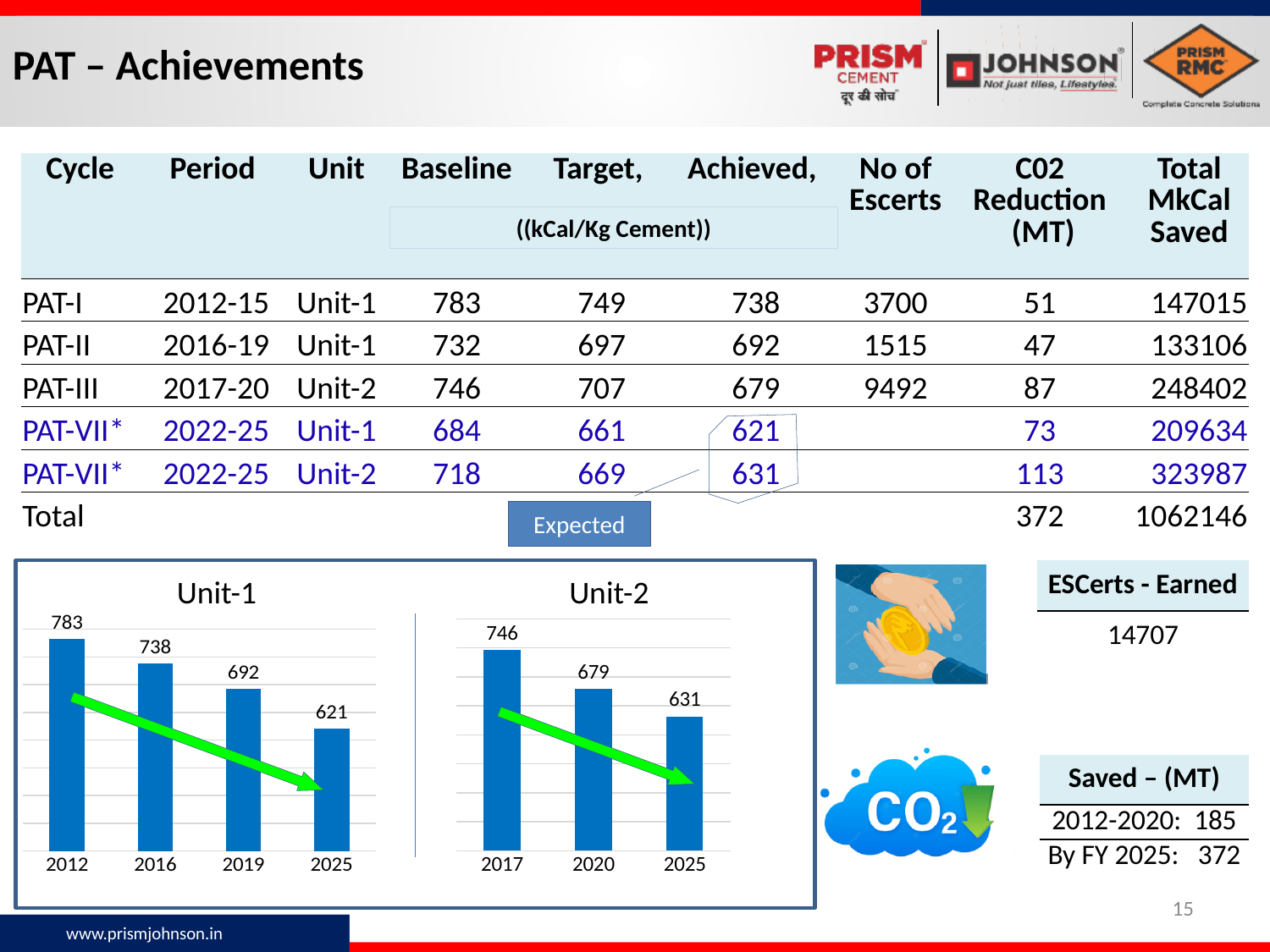
How many bars are in the Unit-1 chart? 4 In the Unit-2 chart, do the values rise or fall from 2017 to 2025? Fall In the Unit-1 chart, which is larger, the value for 2016 or the value for 2019? 2016 In the Unit-2 chart, what is the value for 2020? 679 In the Unit-1 chart, what is the value for 2012? 783 In the Unit-2 chart, what is the difference between the 2017 value and the 2025 value? 115 In the Unit-1 chart, what is the value for 2025? 621 What kind of chart is the Unit-2 chart? Bar chart In the Unit-2 chart, what is the value for 2017? 746 In the Unit-2 chart, which year has the lowest value? 2025 In the Unit-1 chart, what is the difference between the 2012 value and the 2025 value? 162 In the Unit-1 chart, which year has the highest value? 2012